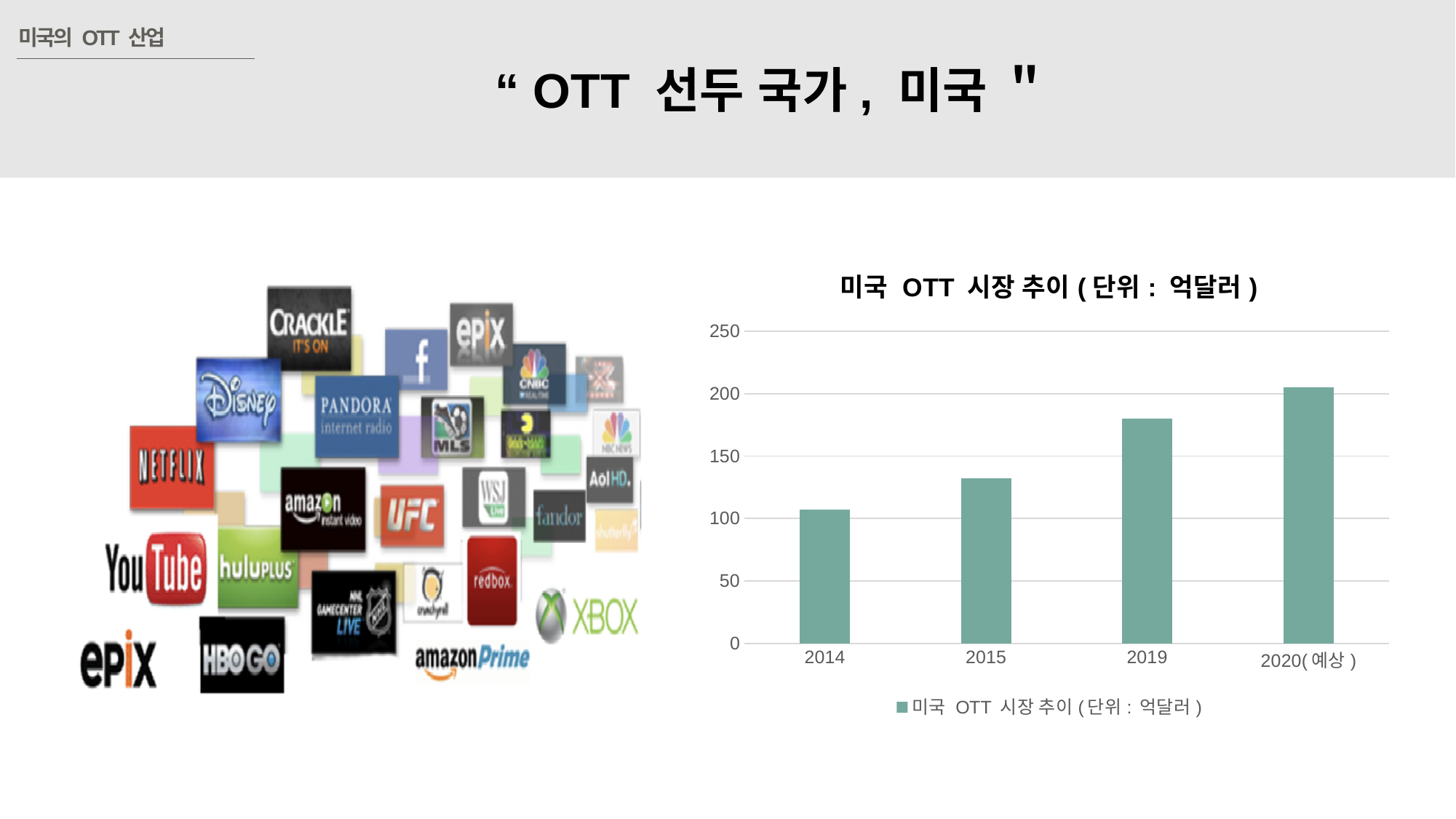
What kind of chart is shown on the slide? bar chart How many series does the chart legend list? 1 What is the label of the last category on the x axis? 2020(예상) Which category has the lowest value in the chart? 2014 Is the value for 2019 greater or less than 150? greater Which is larger, the value for 2015 or the value for 2019? 2019 Which category has the highest value in the chart? 2020(예상) Is the value for 2014 greater or less than 150? less Do the values rise or fall from 2014 to 2020(예상) along the x axis? rise How many categories are shown on the x axis of the chart? 4 Is the value for 2020(예상) greater or less than 200? greater What is the title of the chart? 미국 OTT 시장 추이 (단위 : 억달러)